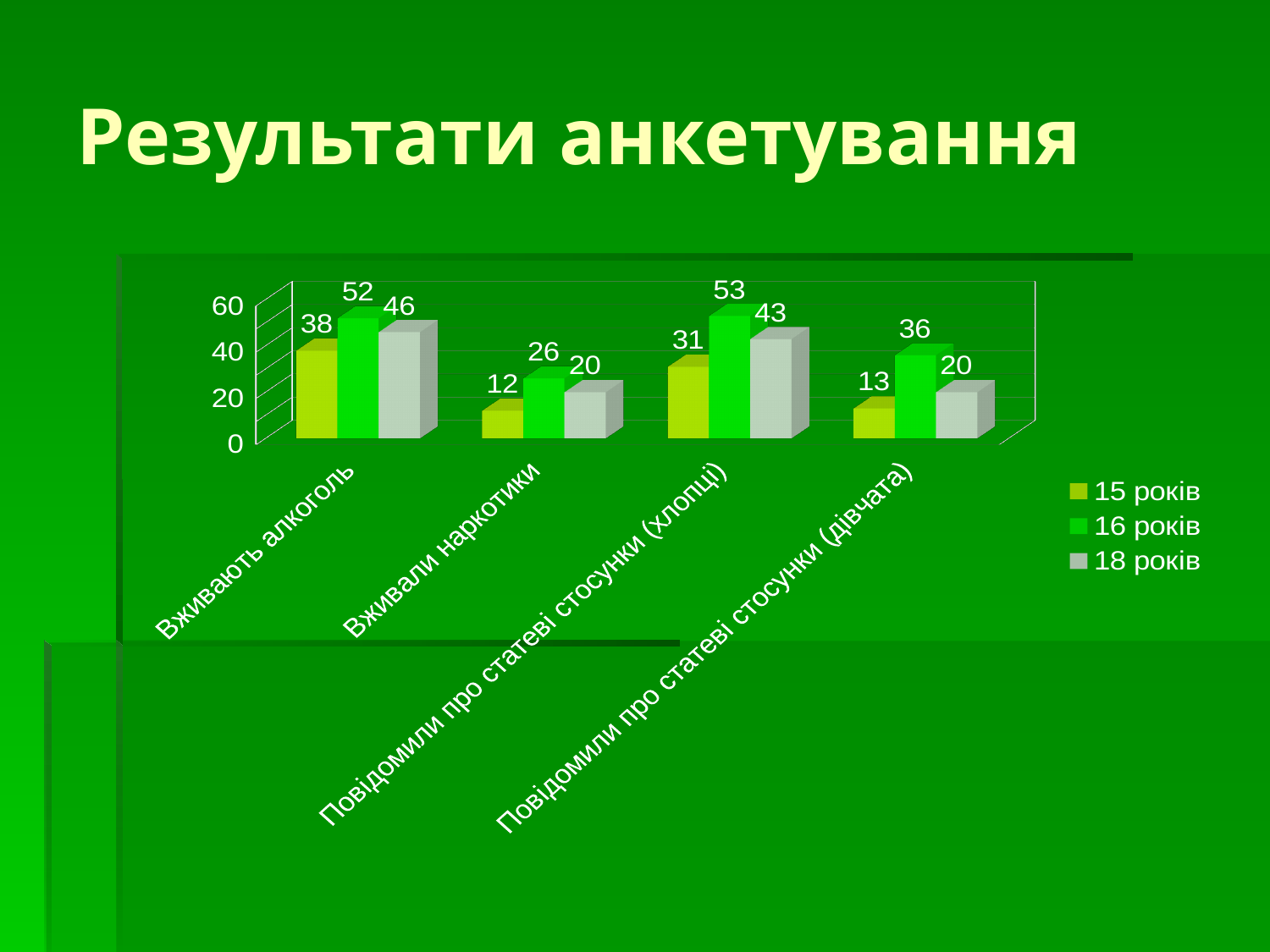
What is the value for "18 років" in the "Повідомили про статеві стосунки (хлопці)" category? 43 What is the difference between the "16 років" and "15 років" values in the "Вживають алкоголь" category? 14 How many series does the chart legend list? 3 Which category has the lowest value for the "15 років" series? Вживали наркотики What is the value for "16 років" in the "Вживають алкоголь" category? 52 What is the value for "16 років" in the "Повідомили про статеві стосунки (дівчата)" category? 36 What kind of chart is shown on the slide? Bar chart What is the value for "15 років" in the "Вживали наркотики" category? 12 What is the title of the slide containing the chart? Результати анкетування Which category has the highest value for the "16 років" series? Повідомили про статеві стосунки (хлопці) In the "Повідомили про статеві стосунки (дівчата)" category, which is larger: the value for "15 років" or for "18 років"? 18 років How many categories are shown on the x axis of the chart? 4